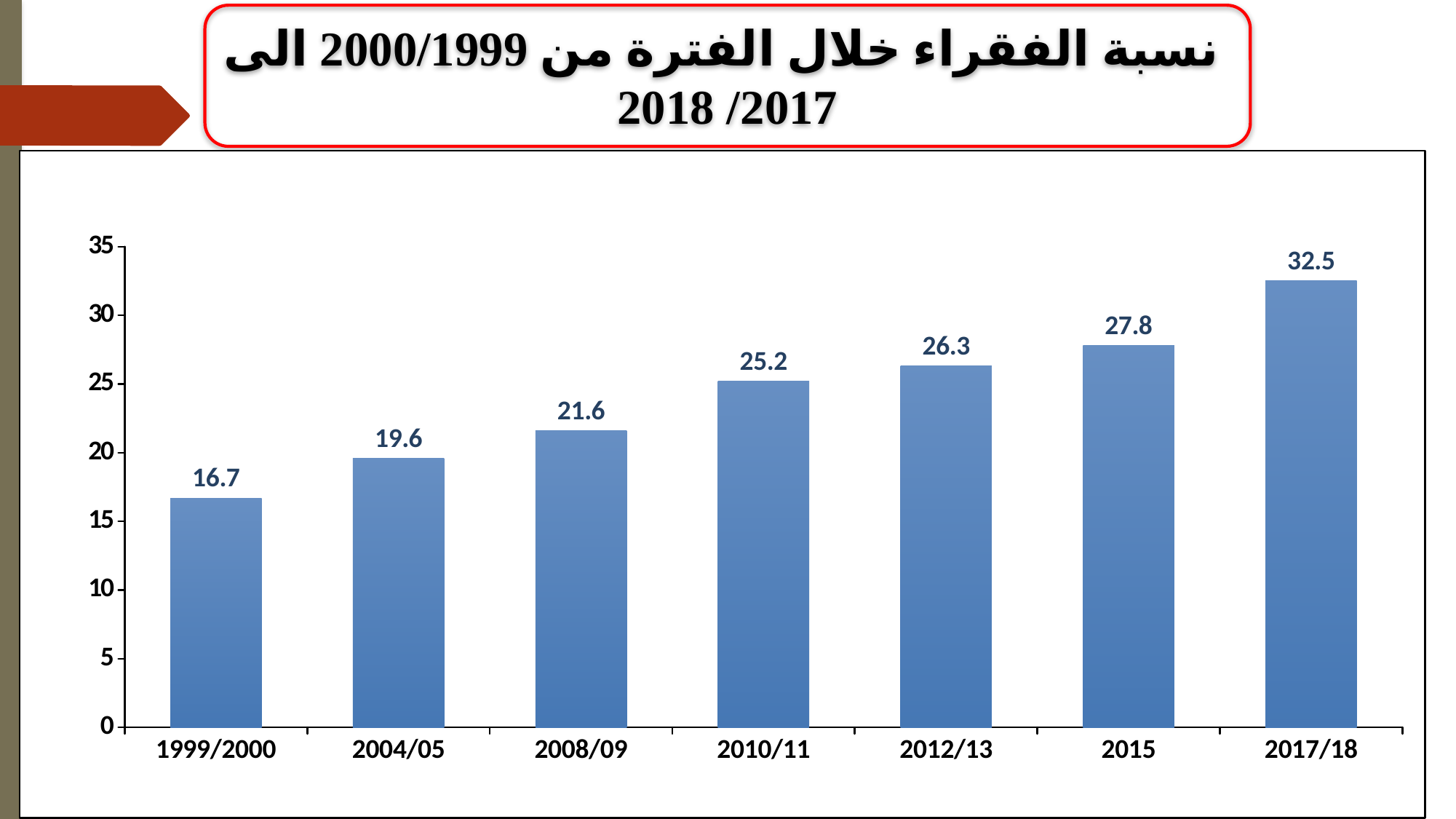
Which is larger, the value for 2004/05 or the value for 2008/09? 2008/09 Do the values rise or fall from 1999/2000 to 2017/18? rise What kind of chart is this? bar chart Which period has the lowest value? 1999/2000 What is the difference between the values for 2012/13 and 2008/09? 4.7 What is the value for 2010/11? 25.2 What is the value for 1999/2000? 16.7 Is the value for 2017/18 greater or less than 30? greater How many periods are shown on the x axis? 7 Which period has the highest value? 2017/18 What is the difference between the values for 2017/18 and 1999/2000? 15.8 What is the value for 2015? 27.8